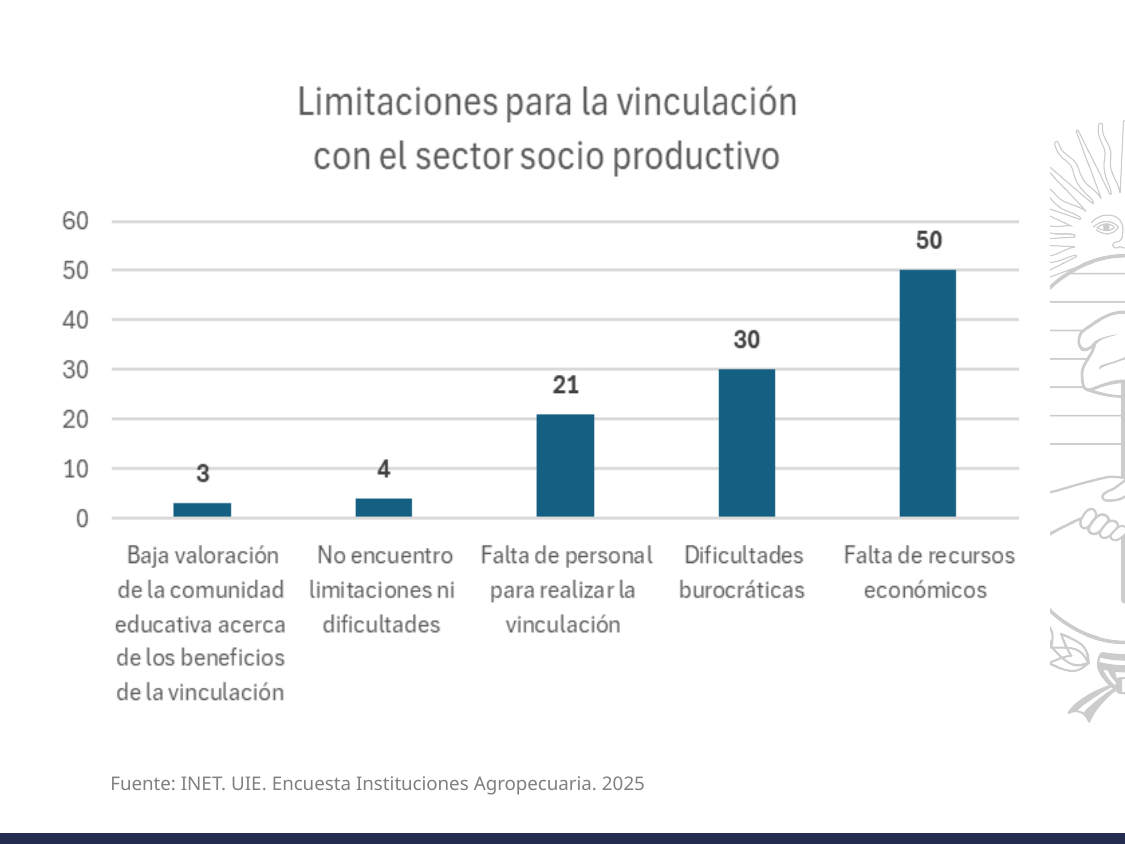
What is the value for 'Falta de recursos económicos'? 50 Which is larger, the value for 'Falta de personal para realizar la vinculación' or the value for 'Dificultades burocráticas'? Dificultades burocráticas Which category has the lowest value? Baja valoración de la comunidad educativa acerca de los beneficios de la vinculación How many categories are shown in the chart? 5 What is the difference between the values for 'Falta de recursos económicos' and 'Dificultades burocráticas'? 20 What is the value for 'Dificultades burocráticas'? 30 What is the title of the chart? Limitaciones para la vinculación con el sector socio productivo What is the value for 'No encuentro limitaciones ni dificultades'? 4 Which category has the highest value? Falta de recursos económicos What kind of chart is shown on the slide? Bar chart Is the value for 'Falta de recursos económicos' greater or less than 40? greater What is the value for 'Falta de personal para realizar la vinculación'? 21